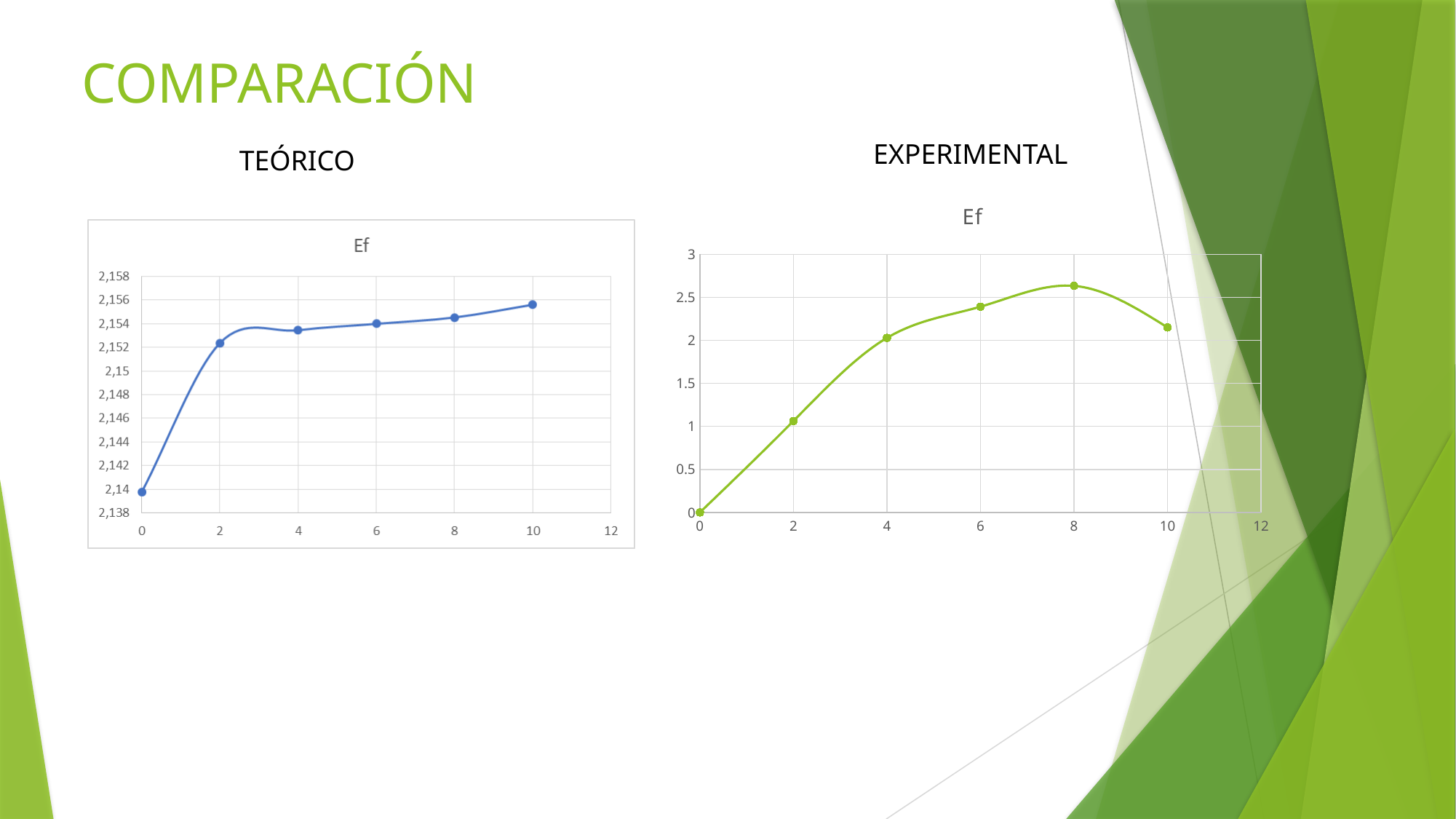
What kind of chart is the TEÓRICO chart on the left? line chart On the TEÓRICO chart, at which x value is Ef highest? 10 On the EXPERIMENTAL chart, is the value at x = 8 greater or less than 2.5? greater On the EXPERIMENTAL chart, at which x value is Ef lowest? 0 What kind of chart is the EXPERIMENTAL chart on the right? line chart On the TEÓRICO chart, at which x value is Ef lowest? 0 On the EXPERIMENTAL chart, at which x value is Ef highest? 8 How many data points are plotted on the EXPERIMENTAL chart? 6 How many data points are plotted on the TEÓRICO chart? 6 On the TEÓRICO chart, is the value at x = 2 greater or less than 2,15? greater On the EXPERIMENTAL chart, is the value at x = 2 greater or less than 1.5? less What is the title shown on both charts? Ef